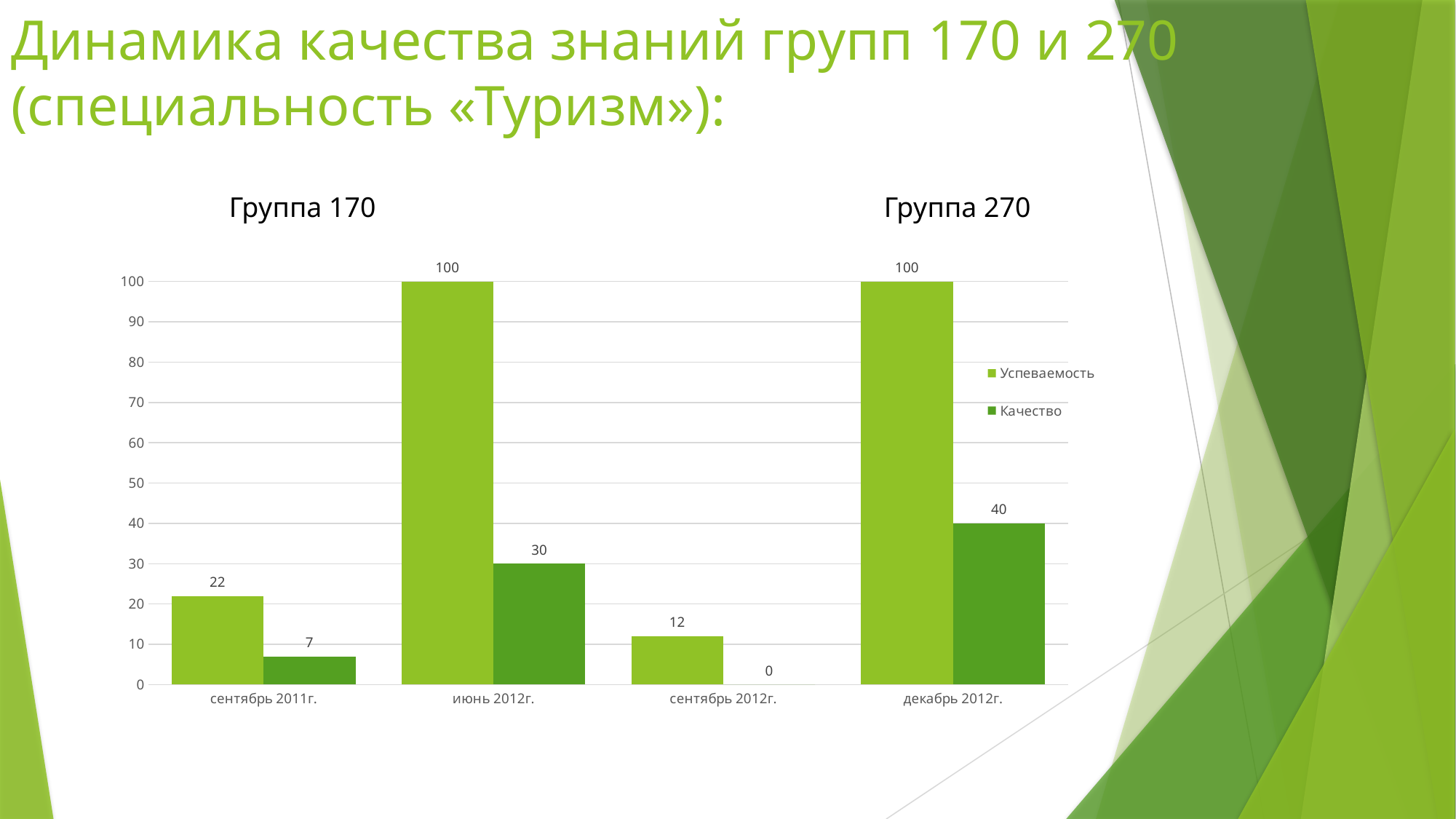
What kind of chart is shown on the slide? bar chart What is the difference between the Успеваемость and Качество values for июнь 2012г.? 70 What is the Качество value for июнь 2012г.? 30 What is the Качество value for сентябрь 2012г.? 0 Which is larger: the Качество value for июнь 2012г. or for декабрь 2012г.? декабрь 2012г. Which category has the highest Качество value? декабрь 2012г. What are the two series names listed in the legend? Успеваемость and Качество What is the Успеваемость value for сентябрь 2011г.? 22 How many series does the legend list? 2 How many categories are shown on the x axis? 4 Which category has the lowest Успеваемость value? сентябрь 2012г. What is the Качество value for декабрь 2012г.? 40